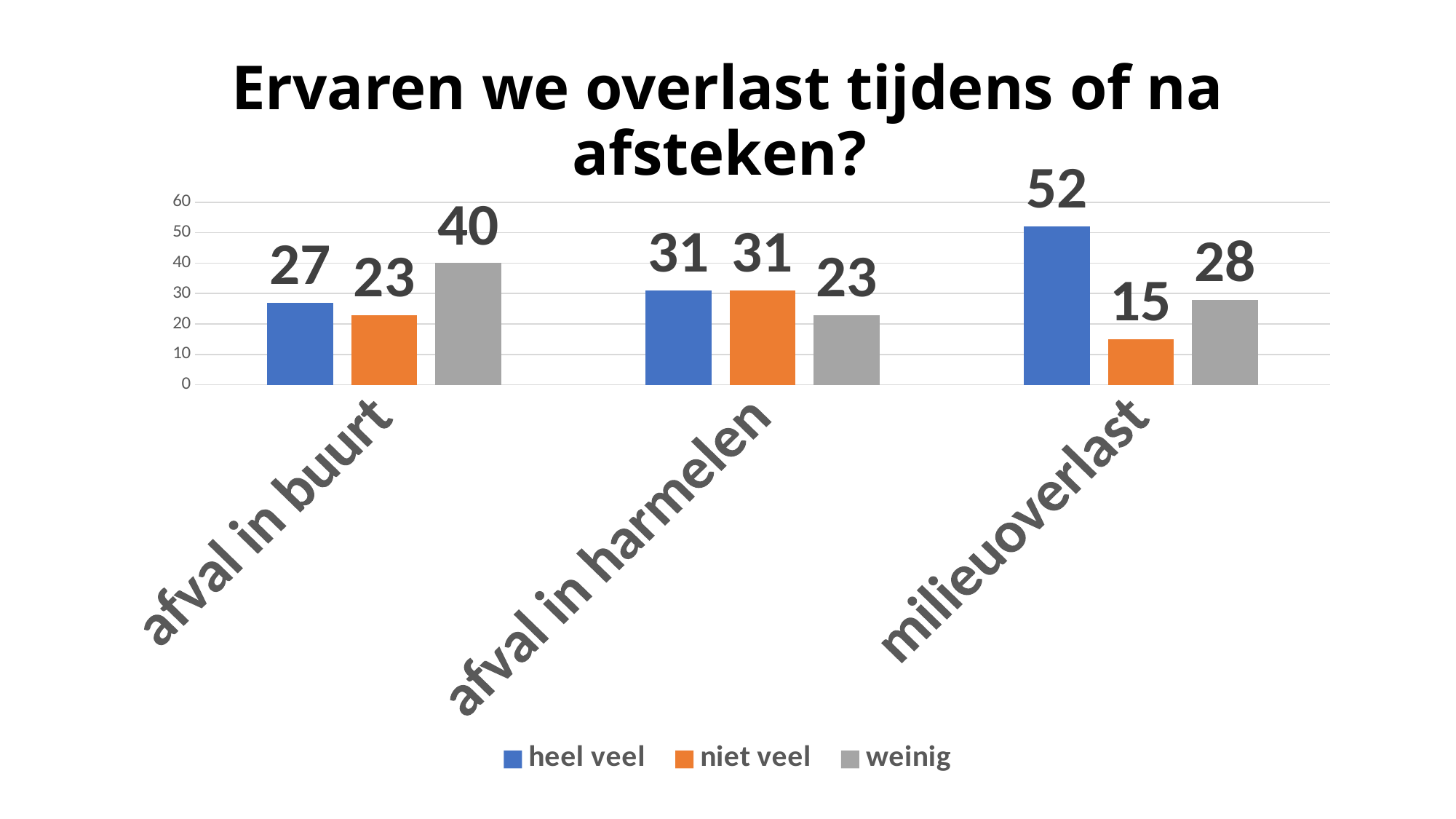
Which is larger for 'afval in buurt': 'heel veel' or 'weinig'? weinig Which category has the lowest 'niet veel' value? milieuoverlast How many series does the legend list? 3 What is the value for 'niet veel' in the 'afval in harmelen' category? 31 What is the value for 'heel veel' in the 'afval in buurt' category? 27 How many categories are shown on the x axis? 3 What is the difference between the 'heel veel' and 'niet veel' values for 'milieuoverlast'? 37 Is the 'heel veel' value for 'milieuoverlast' greater or less than 50? greater Which category has the highest 'heel veel' value? milieuoverlast What is the value for 'weinig' in the 'milieuoverlast' category? 28 What is the title of the chart? Ervaren we overlast tijdens of na afsteken? What kind of chart is shown on the slide? bar chart